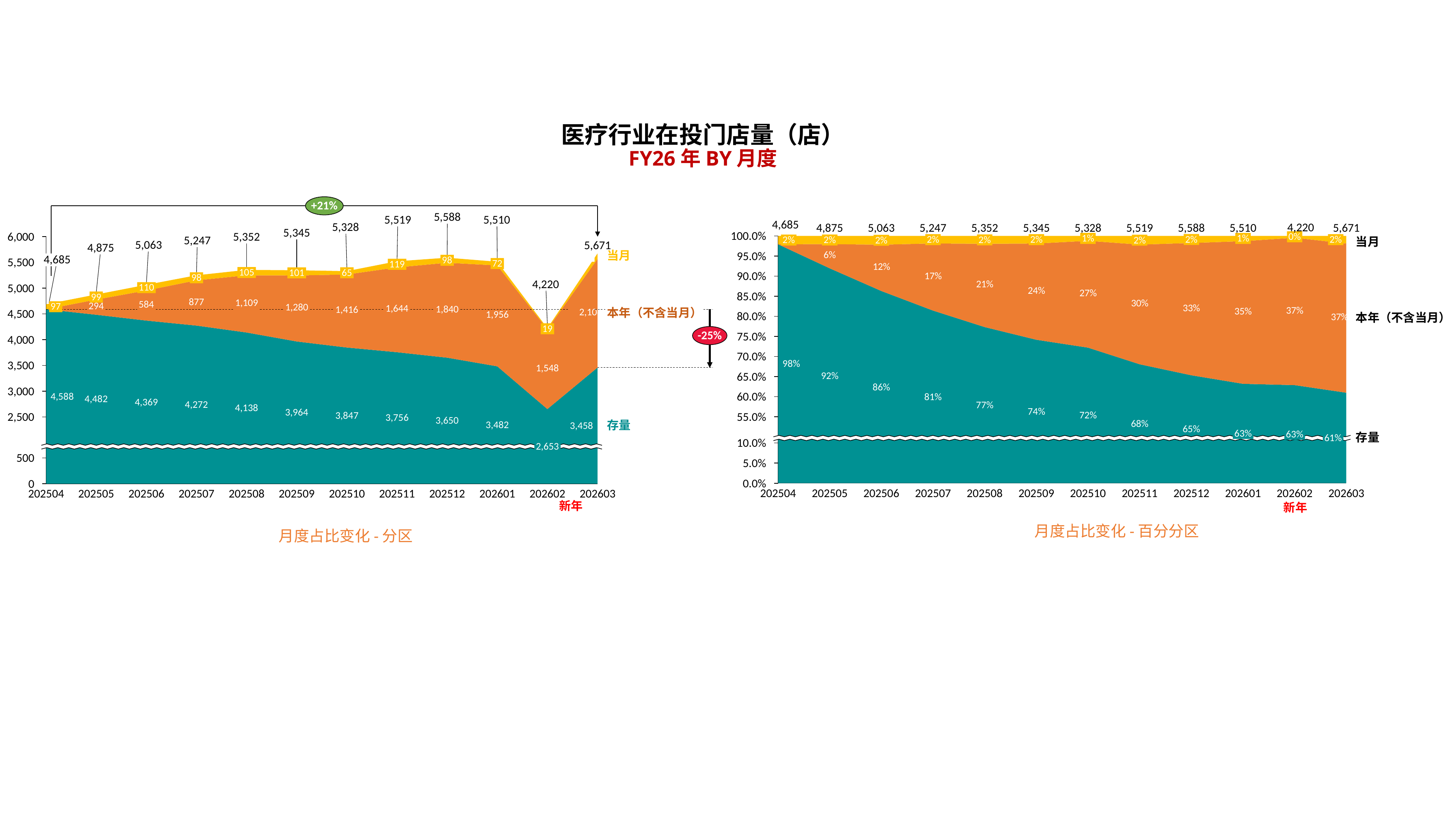
In the left chart (月度占比变化 - 分区), which month has the lowest total value? 202602 In the left chart (月度占比变化 - 分区), which month has the highest total value? 202603 In the right chart (月度占比变化 - 百分分区), what is the 存量 share for 202508? 77% In the left chart (月度占比变化 - 分区), is the 当月 value larger for 202510 or 202601? 202601 In the right chart (月度占比变化 - 百分分区), does the 存量 share rise or fall from 202504 to 202603? fall In the right chart (月度占比变化 - 百分分区), what is the 本年（不含当月） share for 202512? 33% In the left chart (月度占比变化 - 分区), what is the total value shown for 202512? 5,588 In the left chart (月度占比变化 - 分区), what is the difference between the 存量 values for 202504 and 202603? 1,130 In the left chart (月度占比变化 - 分区), what is the 本年（不含当月） value for 202601? 1,956 In the left chart (月度占比变化 - 分区), what is the 当月 value for 202511? 119 How many months are plotted on the x axis of the left chart (月度占比变化 - 分区)? 12 In the left chart (月度占比变化 - 分区), what is the 存量 value for 202602? 2,653